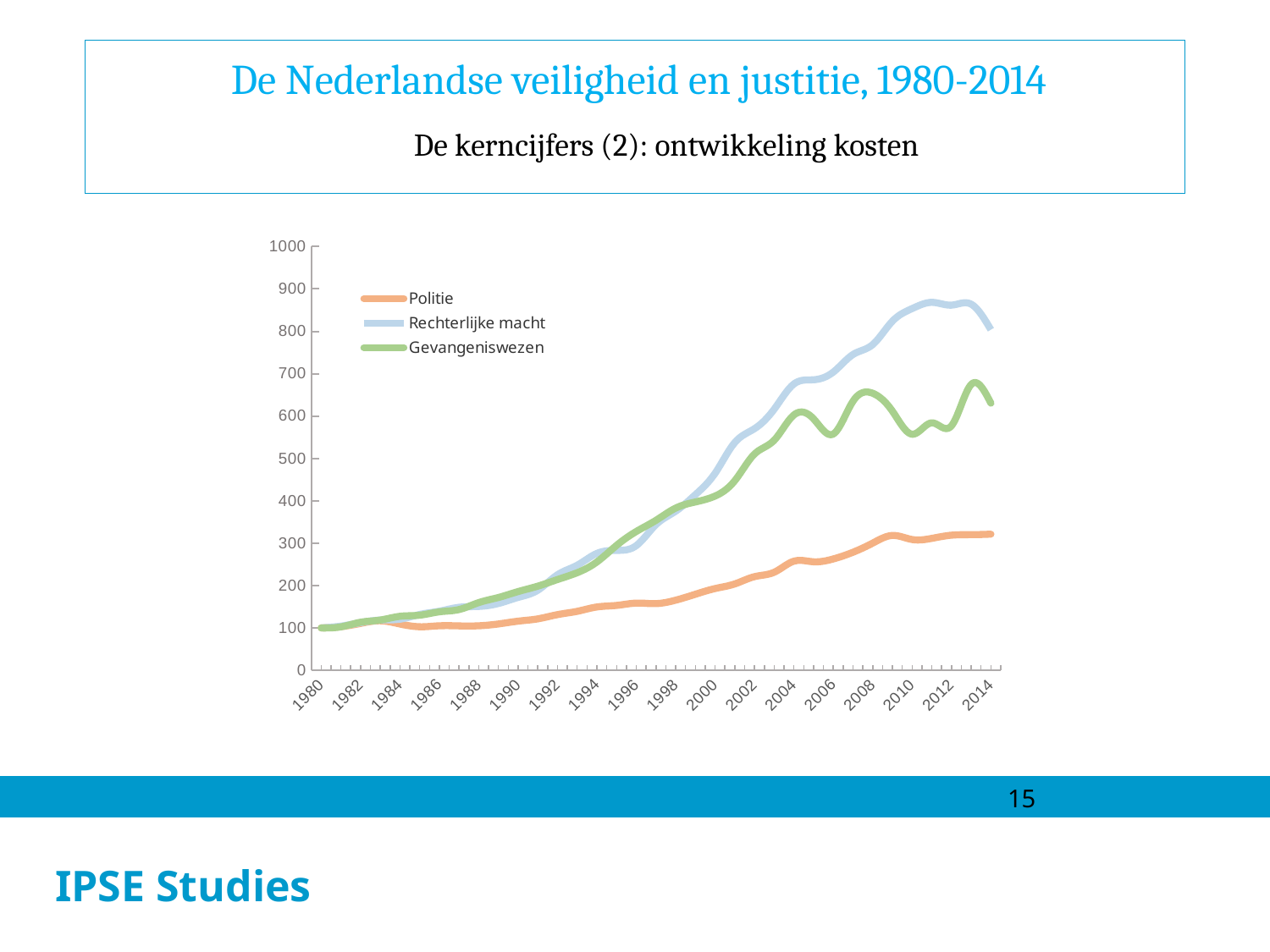
Is the value for Politie in 2014 greater or less than 400? less In 2004, which is larger: Rechterlijke macht or Gevangeniswezen? Rechterlijke macht What is the value of all three series in 1980? 100 What kind of chart is shown on the slide? line chart Which series are listed in the legend? Politie, Rechterlijke macht, Gevangeniswezen Is the value for Politie in 1990 greater or less than 200? less How many series does the legend list? 3 Is the value for Gevangeniswezen in 2008 greater or less than 600? greater Does the Politie series generally rise or fall from 1980 to 2014? rise Which series has the highest value in 2014? Rechterlijke macht Which series has the lowest value in 2014? Politie